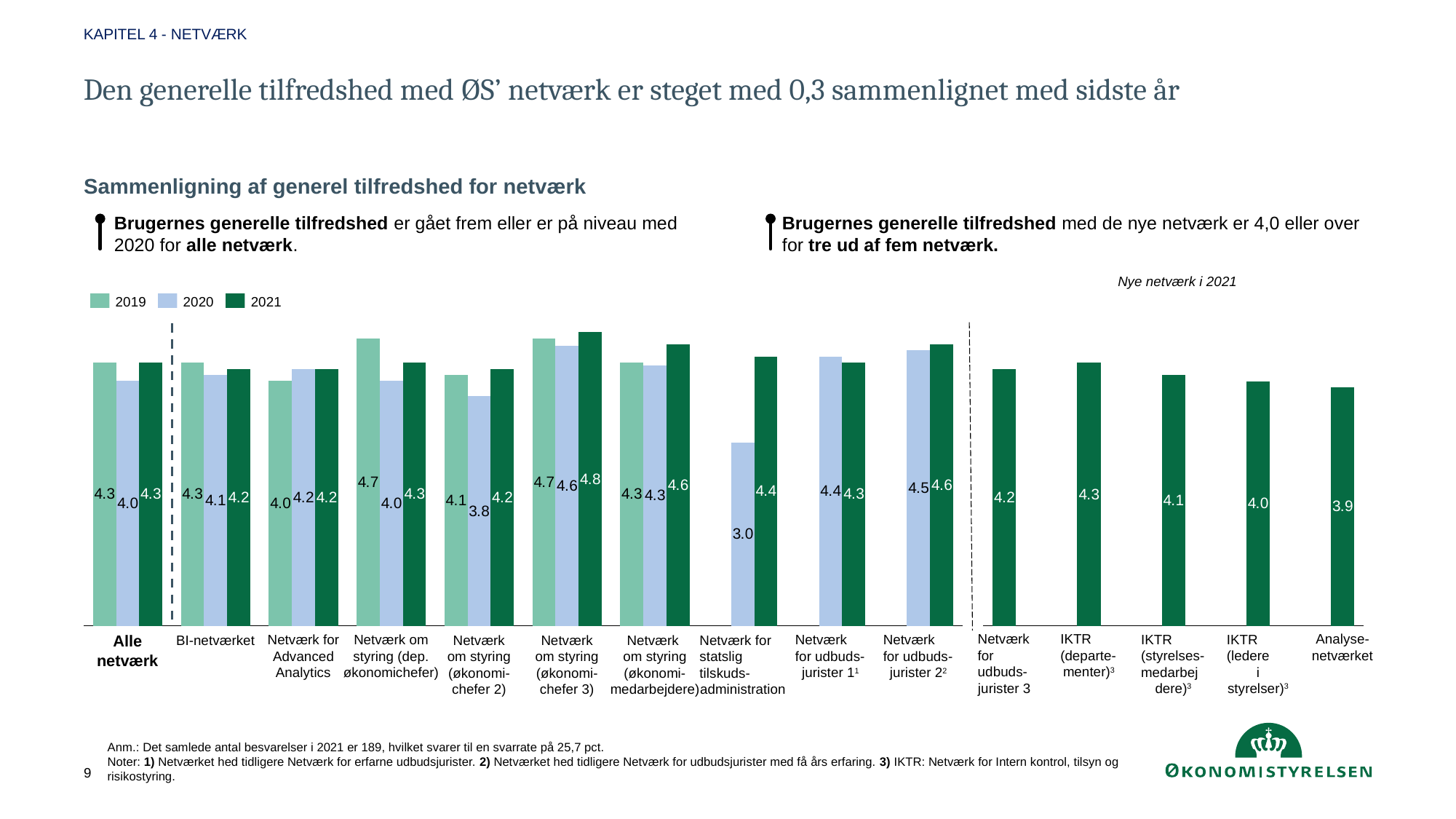
What is the difference between the 2021 and 2020 values for Netværk for statslig tilskudsadministration? 1.4 What is the difference between the 2021 and 2020 values for Alle netværk? 0.3 Which is larger for Netværk om styring (økonomichefer 2): the 2019 value or the 2020 value? 2019 What is the 2019 value for Netværk om styring (dep. økonomichefer)? 4.7 How many series does the legend list? 3 What is the 2021 value for Analysenetværket? 3.9 What kind of chart is this? Bar chart Which category has the highest 2021 value? Netværk om styring (økonomichefer 3) What is the 2020 value for Netværk for statslig tilskudsadministration? 3.0 What is the 2021 value for Alle netværk? 4.3 Which category has the lowest 2020 value? Netværk for statslig tilskudsadministration How many categories are shown on the x axis? 15